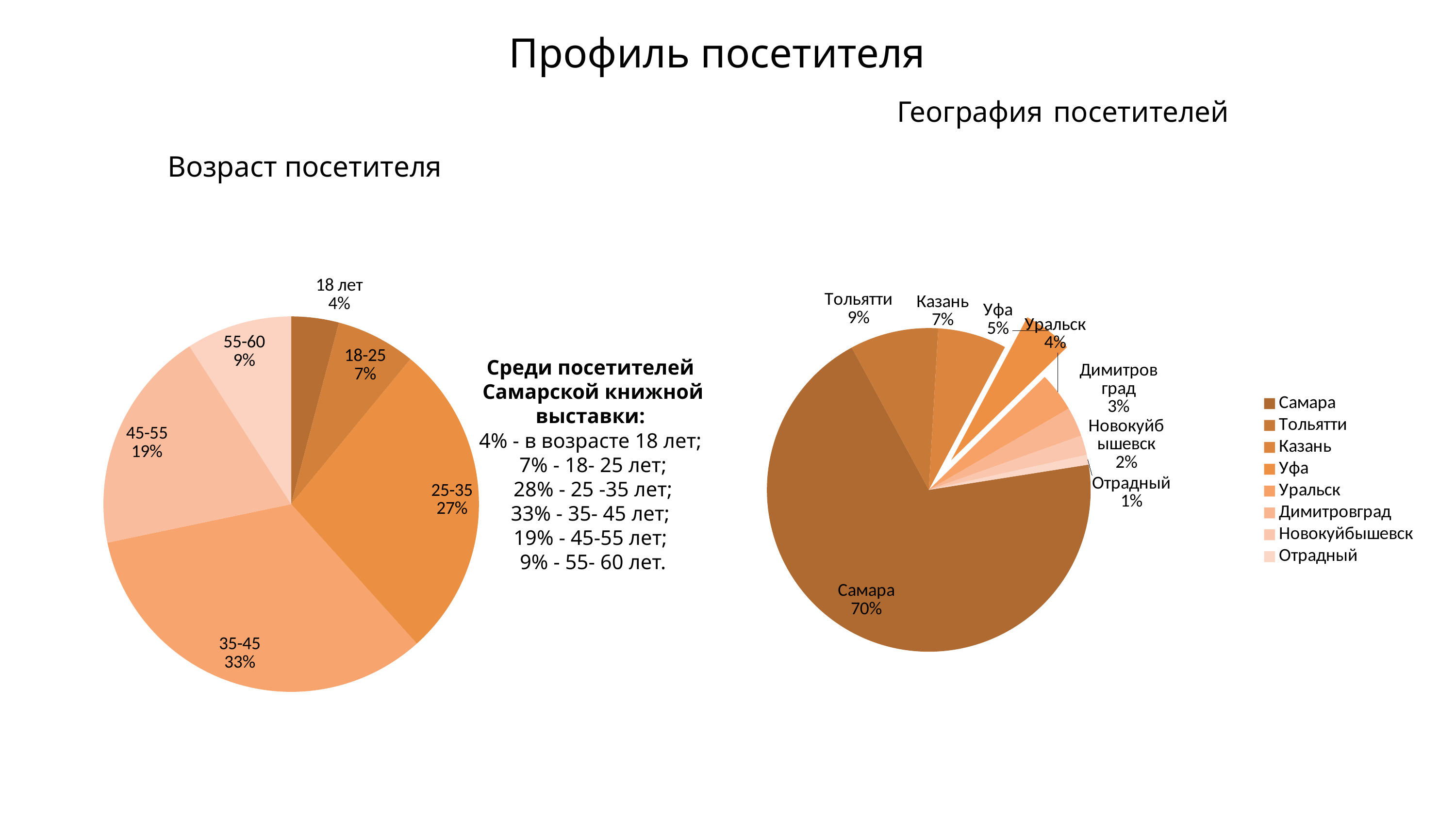
On the "География посетителей" chart, what share of visitors come from Тольятти? 9% On the "География посетителей" chart, which has a larger share, Казань or Уфа? Казань On the "География посетителей" chart, which city has the smallest share? Отрадный On the "Возраст посетителя" chart, what share of visitors are aged 35-45? 33% What kind of chart is the "География посетителей" chart? Pie chart On the "География посетителей" chart, what share of visitors come from Самара? 70% How many entries does the legend of the "География посетителей" chart list? 8 On the "Возраст посетителя" chart, what is the difference in percentage points between the 45-55 and 55-60 groups? 10 On the "Возраст посетителя" chart, which age group has the smallest share? 18 лет On the "Возраст посетителя" chart, how many age groups are shown? 6 On the "Возраст посетителя" chart, what share of visitors are aged 45-55? 19% On the "Возраст посетителя" chart, which age group has the largest share? 35-45